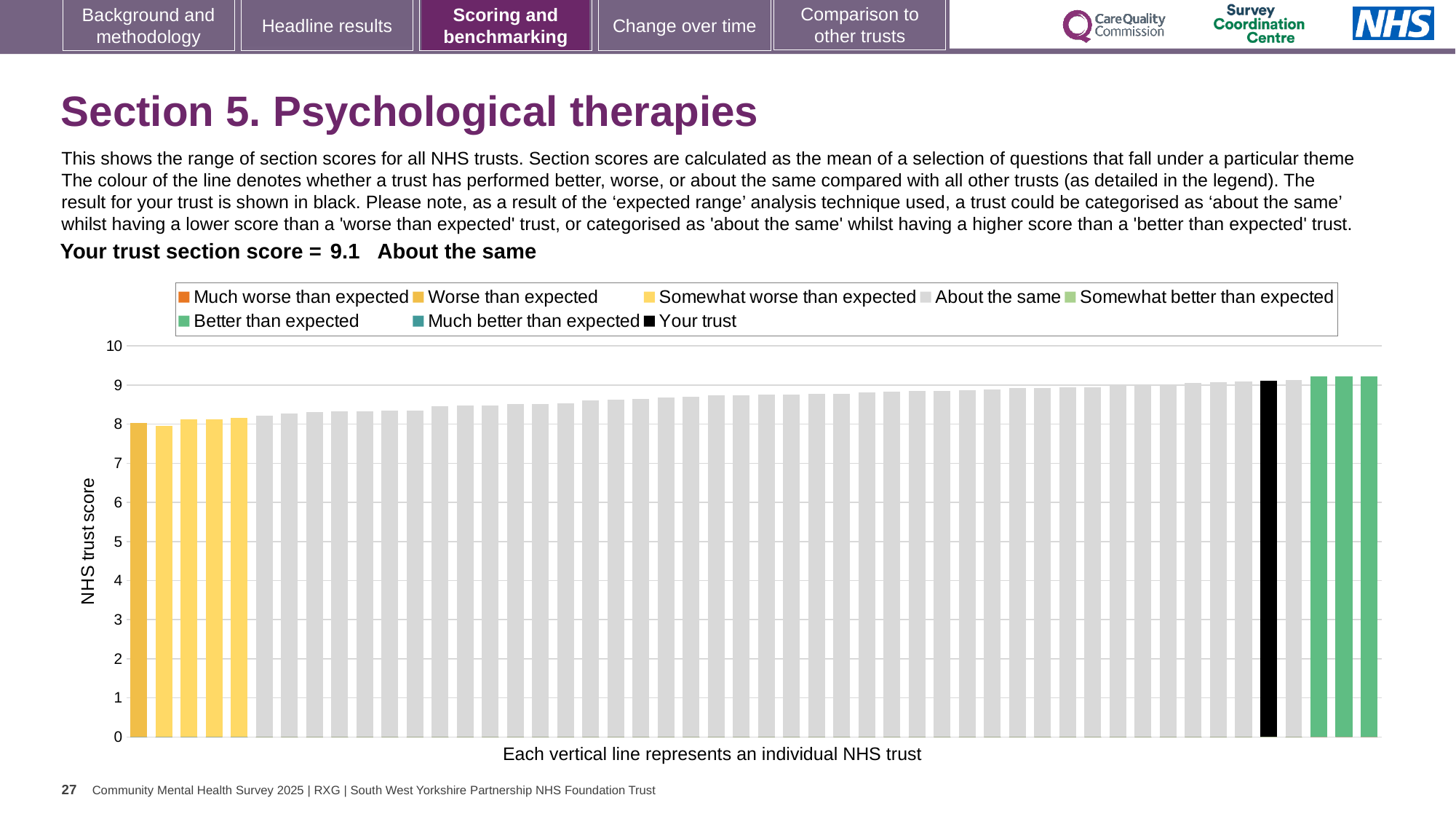
Is the value for your trust (the black bar) greater or less than 9? greater Is the bar for your trust taller or shorter than the leftmost bar? Taller What is the section score for your trust shown on the slide? 9.1 What kind of chart is shown on the slide? Bar chart What colour is used for the bar representing your trust? Black Is the value of the lowest bar in the chart greater or less than 7? greater Do the bar values rise or fall from left to right along the x axis? Rise What is the label on the vertical axis of the chart? NHS trust score Which category is your trust placed in for this section? About the same How many entries does the chart legend list? 8 How many green 'Better than expected' bars are shown in the chart? 3 Is the value of the highest bar in the chart greater or less than 10? less